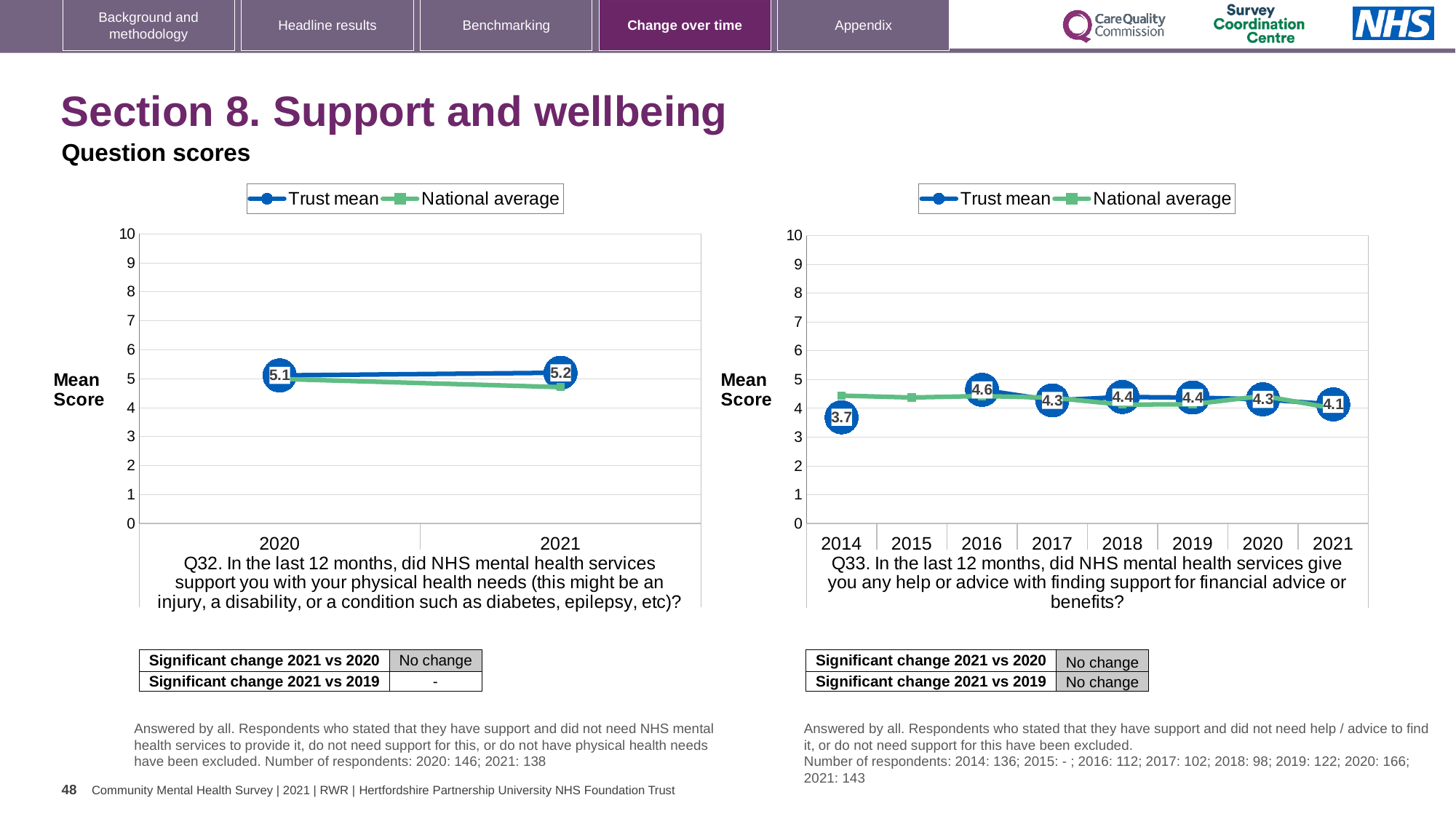
What type of chart is the Q33 chart on the right? Line chart In the Q33 chart on the right, what is the Trust mean for 2014? 3.7 In the Q33 chart on the right, what is the difference between the Trust mean for 2016 and 2014? 0.9 In the Q33 chart on the right, which year has the highest Trust mean? 2016 How many series does the legend of the Q32 chart on the left list? 2 In the Q32 chart on the left, what is the Trust mean for 2020? 5.1 In the Q32 chart on the left, what is the Trust mean for 2021? 5.2 In the Q32 chart on the left, what is the difference between the Trust mean for 2021 and 2020? 0.1 In the Q33 chart on the right, how many years are shown on the x axis? 8 In the Q33 chart on the right, which year has the lowest Trust mean? 2014 In the Q33 chart on the right, what is the Trust mean for 2021? 4.1 In the Q33 chart on the right, is the Trust mean for 2016 greater or less than 4? greater